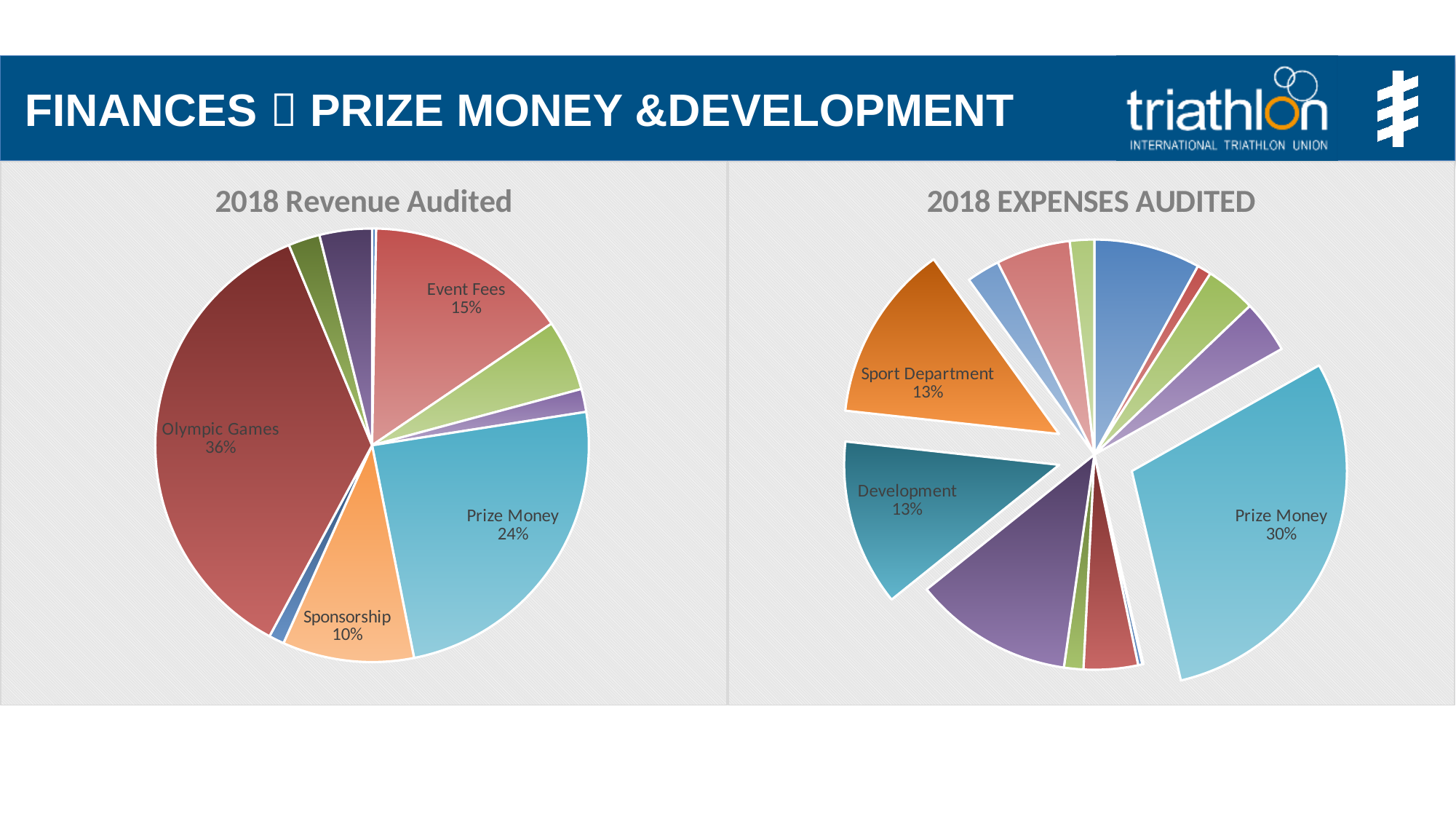
In the 2018 Revenue Audited chart, which labelled category has the largest share? Olympic Games In the 2018 Revenue Audited chart, which is larger, Event Fees or Sponsorship? Event Fees In the 2018 Revenue Audited chart, what share of revenue comes from Olympic Games? 36% In the 2018 EXPENSES AUDITED chart, what percentage is labelled for Sport Department? 13% In the 2018 Revenue Audited chart, what is the share for Prize Money? 24% In the 2018 EXPENSES AUDITED chart, what is the share for Development? 13% In the 2018 Revenue Audited chart, what percentage is labelled for Event Fees? 15% In the 2018 EXPENSES AUDITED chart, how many percentage points larger is Prize Money than Development? 17 In the 2018 EXPENSES AUDITED chart, what share of expenses goes to Prize Money? 30% What type of chart is used for the 2018 EXPENSES AUDITED data? Pie chart In the 2018 Revenue Audited chart, what share does Sponsorship represent? 10% In the 2018 Revenue Audited chart, how many percentage points larger is Olympic Games than Prize Money? 12